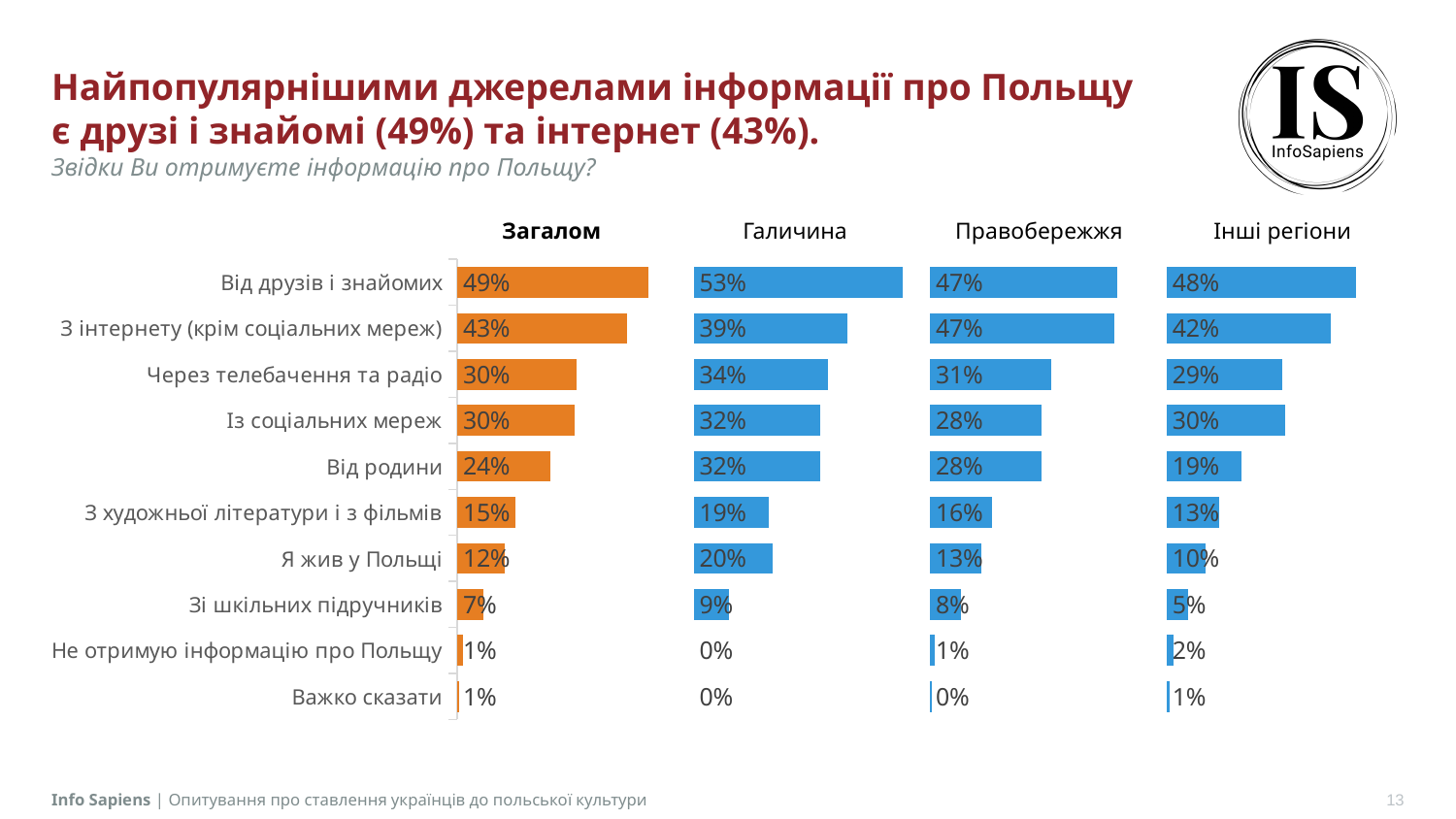
What colour are the bars in the "Загалом" chart? Orange In the "Галичина" chart, what is the value for "Я жив у Польщі"? 20% What type of chart is used for the "Галичина" data? Bar chart In the "Галичина" chart, which category has the highest value? Від друзів і знайомих In the "Інші регіони" chart, what is the value for "Від родини"? 19% In the "Інші регіони" chart, what is the difference between "Від друзів і знайомих" and "Зі шкільних підручників"? 43% In the "Правобережжя" chart, what is the value for "Через телебачення та радіо"? 31% In the "Правобережжя" chart, which is larger: "Із соціальних мереж" or "Через телебачення та радіо"? Через телебачення та радіо How many categories are shown in the "Загалом" chart? 10 In the "Загалом" chart, what is the value for "Від друзів і знайомих"? 49% In the "Загалом" chart, what is the difference between "Від друзів і знайомих" and "З інтернету (крім соціальних мереж)"? 6% In the "Інші регіони" chart, which category has the lowest value? Важко сказати